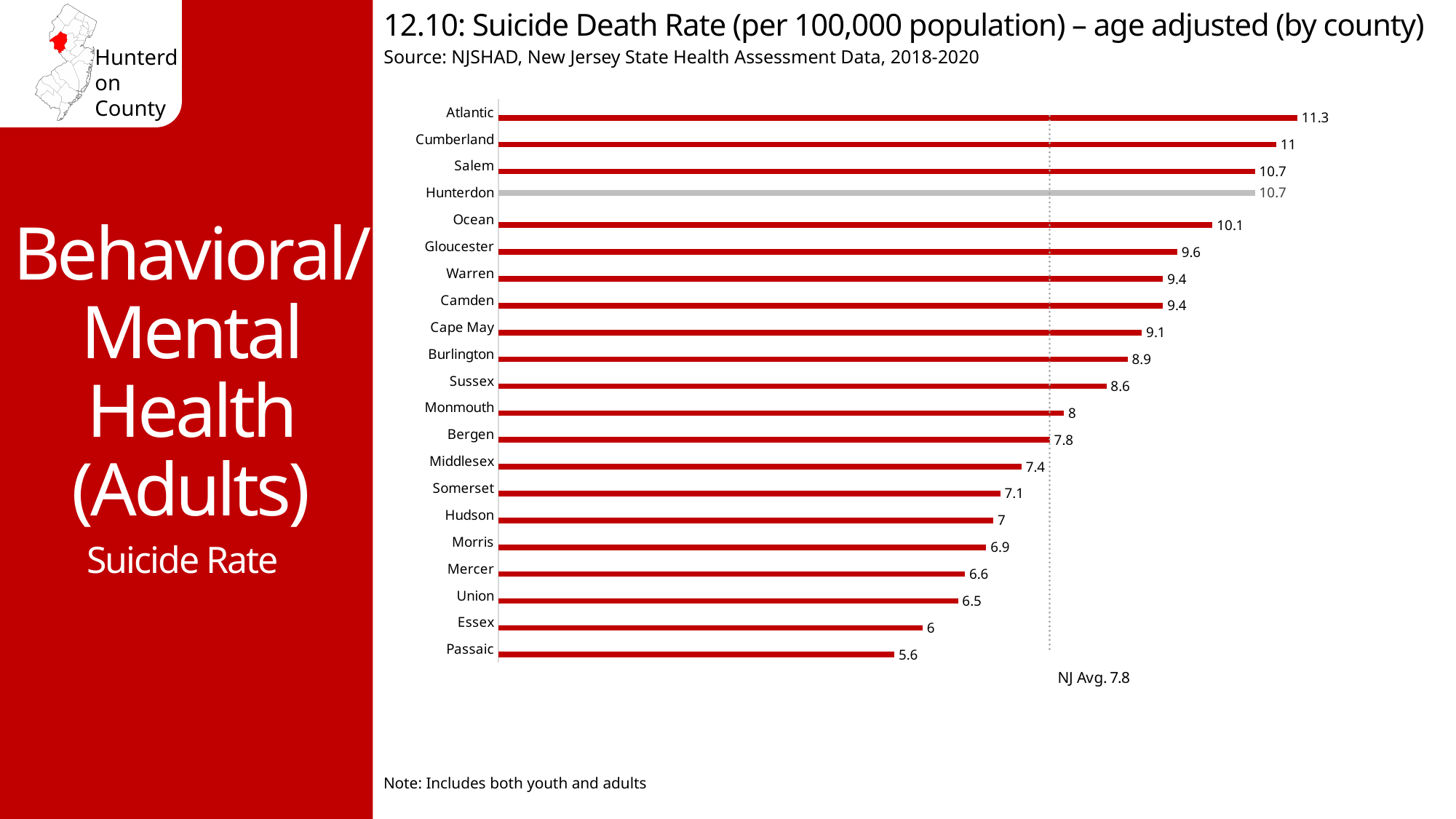
What type of chart is shown on the slide? Bar chart What is the difference between the suicide death rates of Atlantic and Passaic counties? 5.7 What is the suicide death rate for Passaic County? 5.6 How many counties are shown in the chart? 21 How much higher is Hunterdon County's suicide death rate than the NJ average of 7.8? 2.9 What is the suicide death rate for Ocean County? 10.1 What is the NJ average suicide death rate shown on the chart? 7.8 Which county has a higher suicide death rate, Sussex or Monmouth? Sussex Which county has the lowest suicide death rate? Passaic Which county's bar is shown in grey instead of red? Hunterdon Which county has the highest suicide death rate? Atlantic What is the suicide death rate for Hunterdon County? 10.7